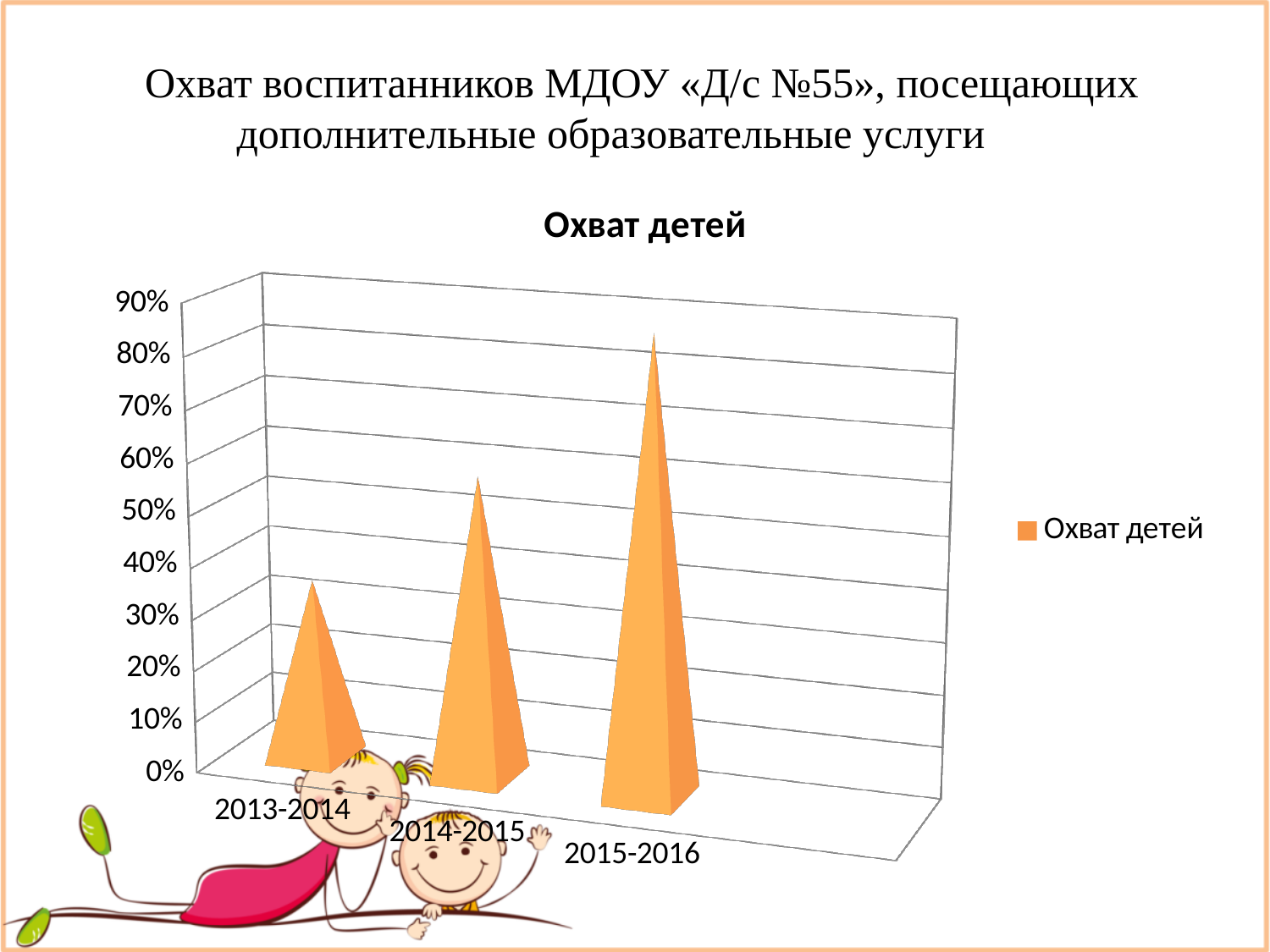
How many series does the chart legend list? 1 Which school year has the lowest value in the chart? 2013-2014 Which is larger, the value for 2014-2015 or the value for 2013-2014? 2014-2015 What colour are the bars in the chart? orange Which school year has the highest value in the chart? 2015-2016 Is the value for 2013-2014 greater or less than 50%? less Is the value for 2014-2015 greater or less than 40%? greater What is the title of the chart? Охват детей Do the values rise or fall from 2013-2014 to 2015-2016? rise How many categories (school years) are shown on the x axis of the chart? 3 Is the value for 2015-2016 greater or less than 60%? greater What kind of chart is shown on the slide? bar chart